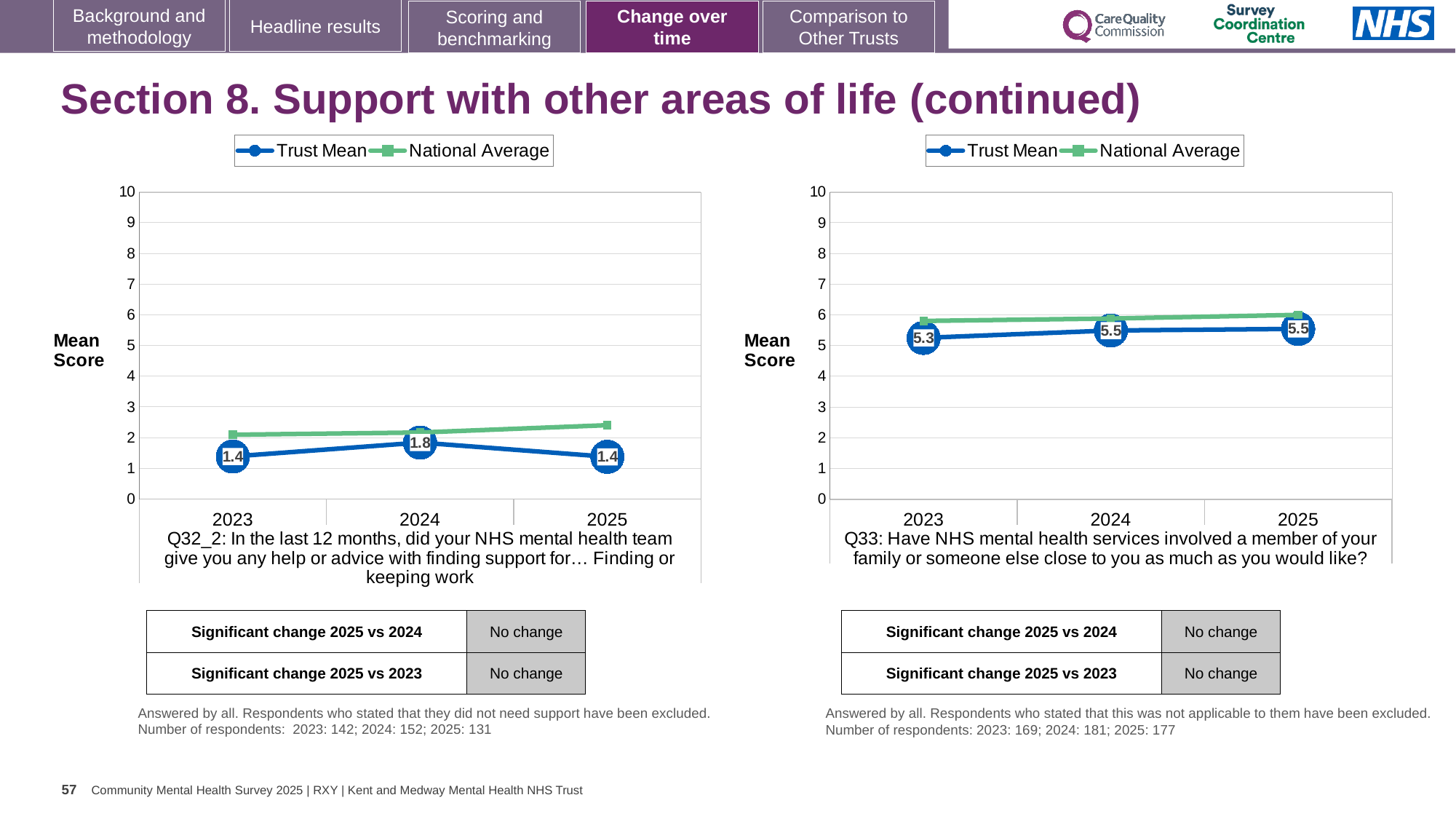
In the left chart (Q32_2), is the National Average for 2025 greater or less than 2? greater In the right chart (Q33), what is the Trust Mean for 2023? 5.3 In the right chart (Q33), what is the Trust Mean for 2025? 5.5 In the left chart (Q32_2), what is the Trust Mean for 2025? 1.4 How many years are plotted on the x axis of the right chart (Q33)? 3 In the left chart (Q32_2), what is the Trust Mean for 2024? 1.8 In the left chart (Q32_2), which year has the highest Trust Mean? 2024 How many series does the legend of the left chart (Q32_2) list? 2 In the right chart (Q33), which is larger in 2023: the Trust Mean or the National Average? National Average What kind of chart is the right chart (Q33)? Line chart In the right chart (Q33), which year has the lowest Trust Mean? 2023 In the left chart (Q32_2), what is the difference between the Trust Mean for 2024 and the Trust Mean for 2023? 0.4